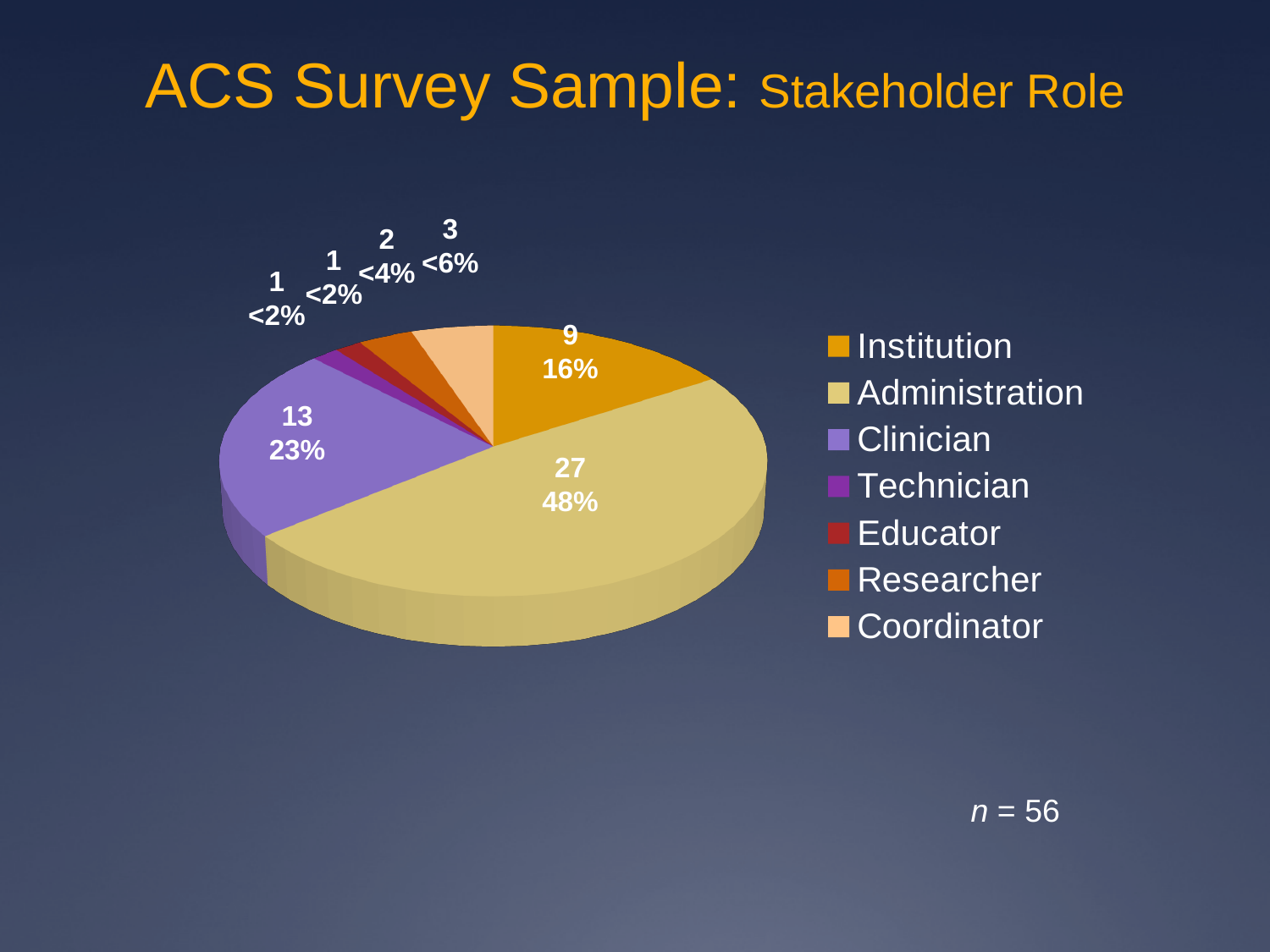
How many respondents are in the Administration slice? 27 How many respondents are in the Institution slice? 9 What kind of chart is shown on the slide? pie chart How many stakeholder roles does the legend list? 7 What share of the pie does Administration represent? 48% What is the total sample size (n) stated on the slide? 56 Which stakeholder role has the largest slice? Administration How many respondents are in the Coordinator slice? 3 Which is larger, the Clinician slice or the Institution slice? Clinician What is the difference in respondent count between Administration and Clinician? 14 What percentage of the sample is Clinician? 23% What is the title of the slide? ACS Survey Sample: Stakeholder Role